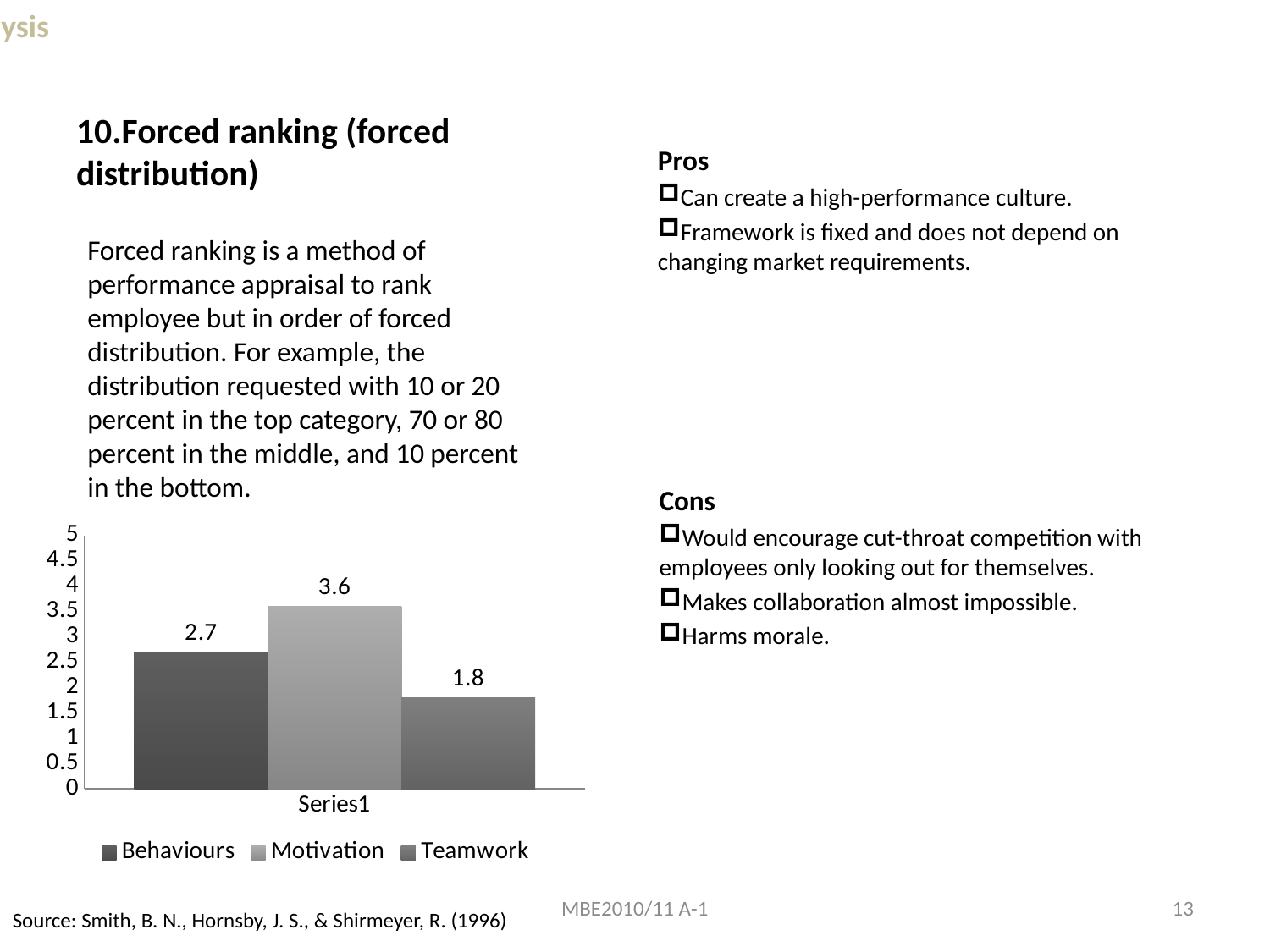
How many series does the legend list? 3 Which series has the highest value? Motivation What is the value for Behaviours? 2.7 Is the value for Motivation greater or less than 3? greater Which series has the lowest value? Teamwork What is the difference between the values for Motivation and Behaviours? 0.9 Which is larger, the value for Behaviours or the value for Teamwork? Behaviours What is the value for Teamwork? 1.8 What kind of chart is shown on the slide? bar chart What is the value for Motivation? 3.6 What is the difference between the values for Behaviours and Teamwork? 0.9 What is the category label shown on the x axis of the chart? Series1